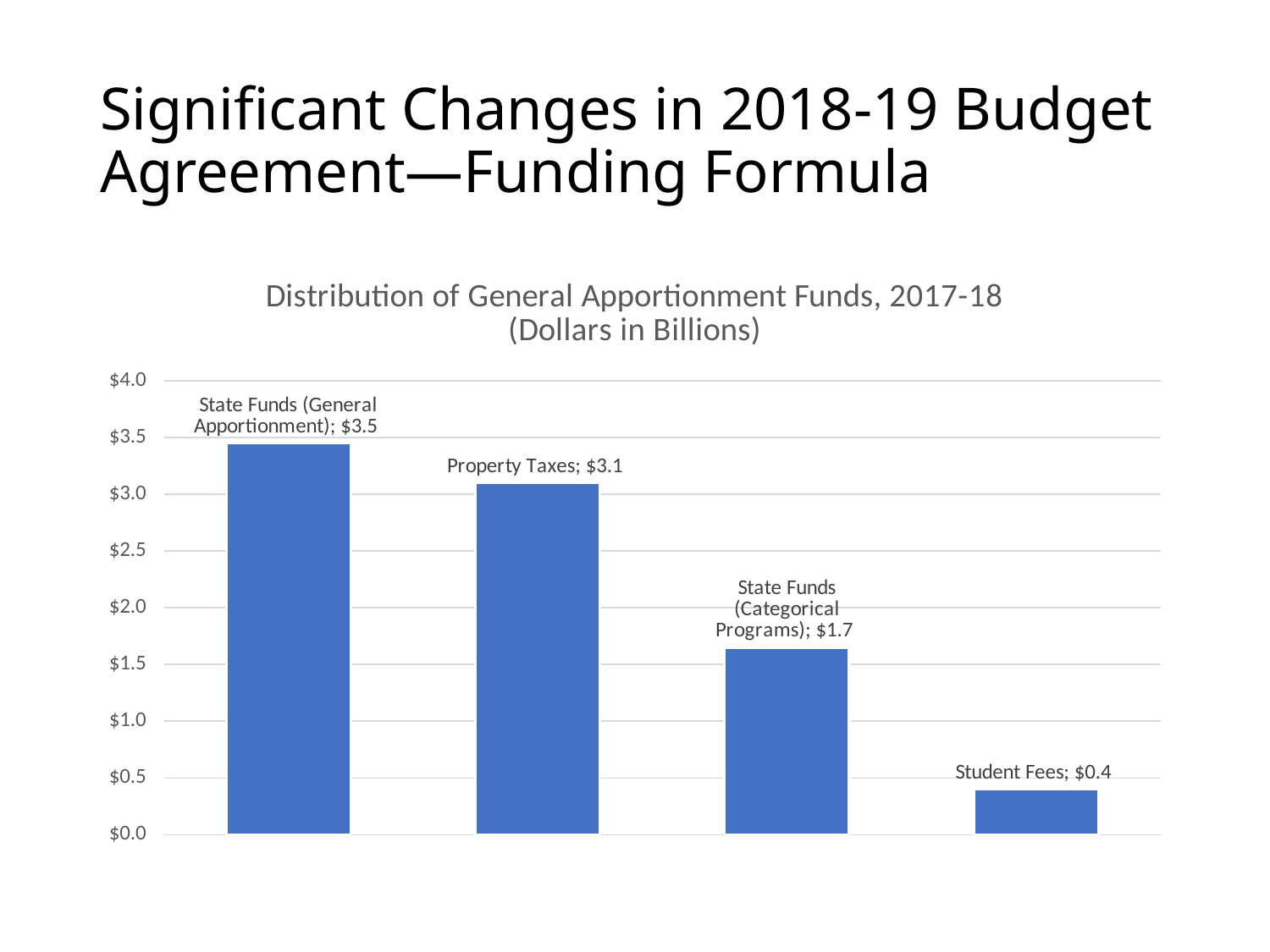
What is the value for Property Taxes? $3.1 Which category has the highest value? State Funds (General Apportionment) Is the value for State Funds (Categorical Programs) greater or less than $2.0? less What is the difference between the values for Property Taxes and State Funds (Categorical Programs)? $1.4 What is the value for State Funds (General Apportionment)? $3.5 What kind of chart is shown on the slide? bar chart What is the value for Student Fees? $0.4 Which is larger, the value for Property Taxes or the value for State Funds (Categorical Programs)? Property Taxes What is the title of the chart? Distribution of General Apportionment Funds, 2017-18 (Dollars in Billions) Which category has the lowest value? Student Fees How many categories are shown in the chart? 4 What is the value for State Funds (Categorical Programs)? $1.7